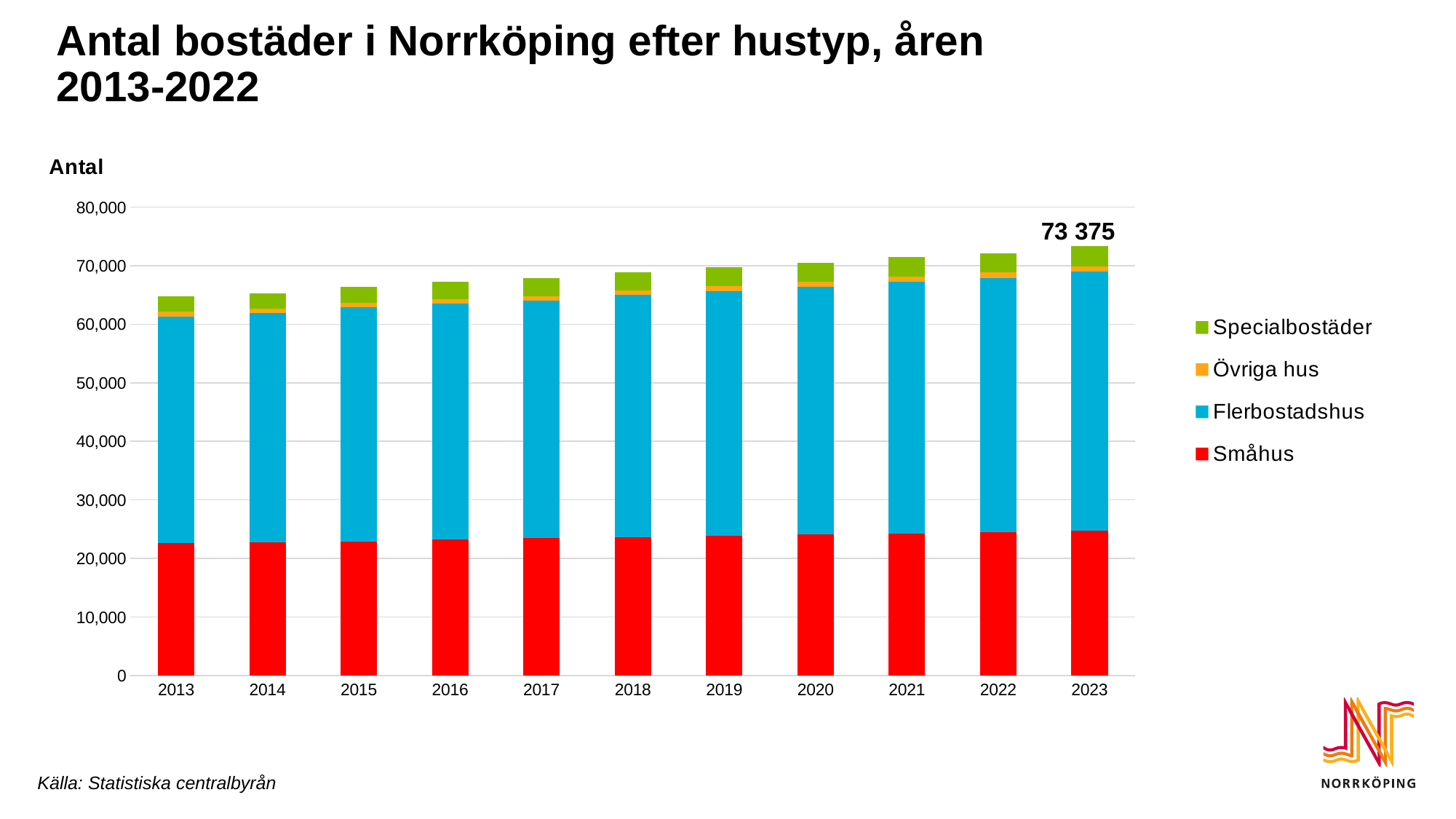
What kind of chart is shown on the slide? Stacked bar chart Is the Småhus segment for 2013 greater or less than 30,000? less Is the total bar for 2013 greater or less than 60,000? greater How many series does the legend list? 4 How many years are shown along the x axis of the chart? 11 Which series is shown in blue in the legend? Flerbostadshus Is the total bar for 2017 greater or less than 70,000? less What is the total number of dwellings shown for 2023? 73 375 Which year has the highest total bar? 2023 Which year has the lowest total bar? 2013 Do the total bar heights rise or fall from 2013 to 2023? Rise Which is larger, the total bar for 2022 or the total bar for 2013? 2022